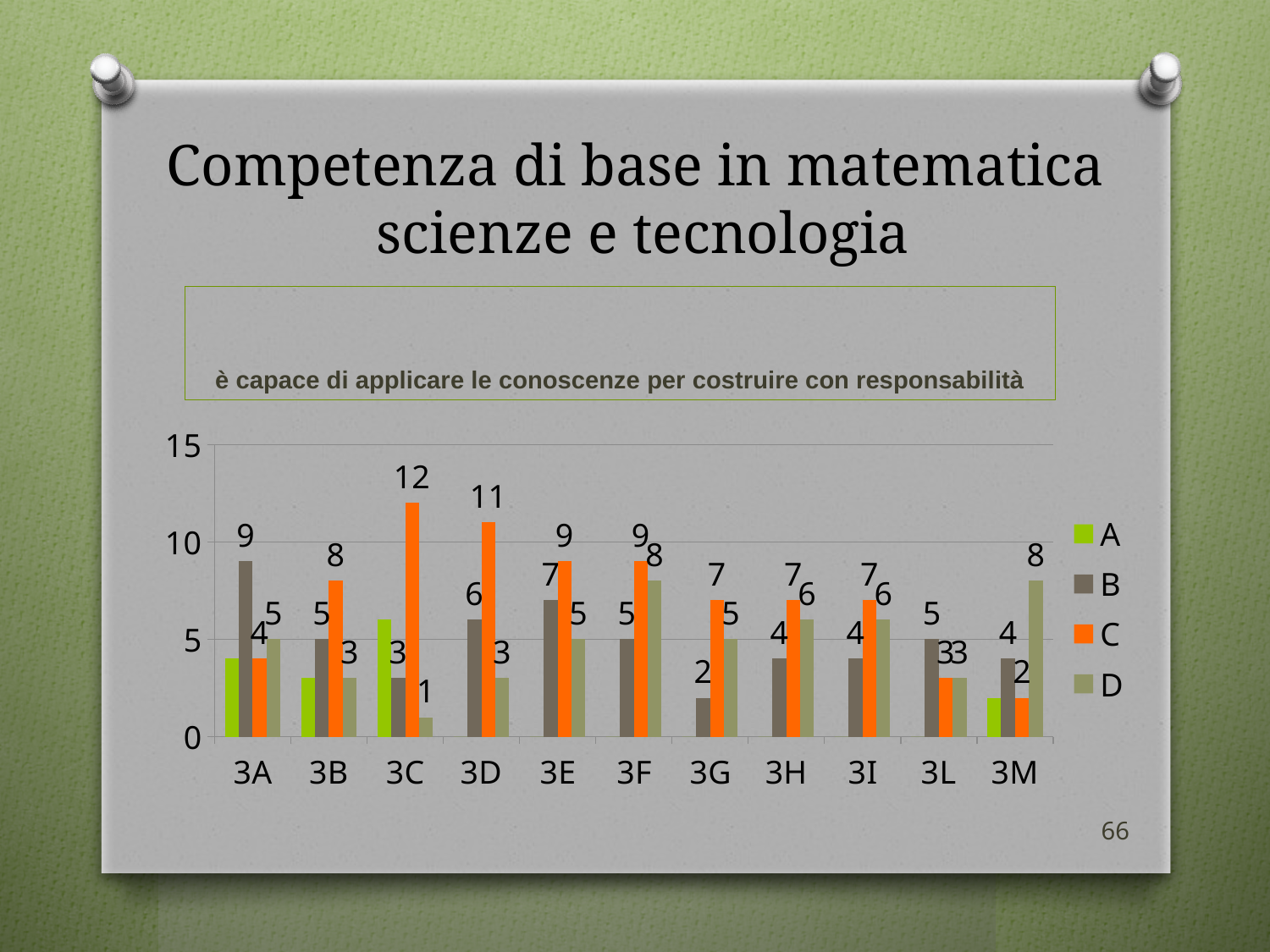
What is the difference between series C and series D for 3C? 11 What is the value of series D for 3M? 8 What is the value of series B for 3G? 2 Is the value of series A for 3B greater or less than 5? less What kind of chart is shown on the slide? bar chart Which category has the highest value for series C? 3C What is the value of series B for 3A? 9 What is the value of series C for 3C? 12 How many categories are shown on the x axis? 11 Which is larger: series D for 3F or series D for 3E? 3F How many series does the legend list? 4 Which category has the lowest value for series D? 3C